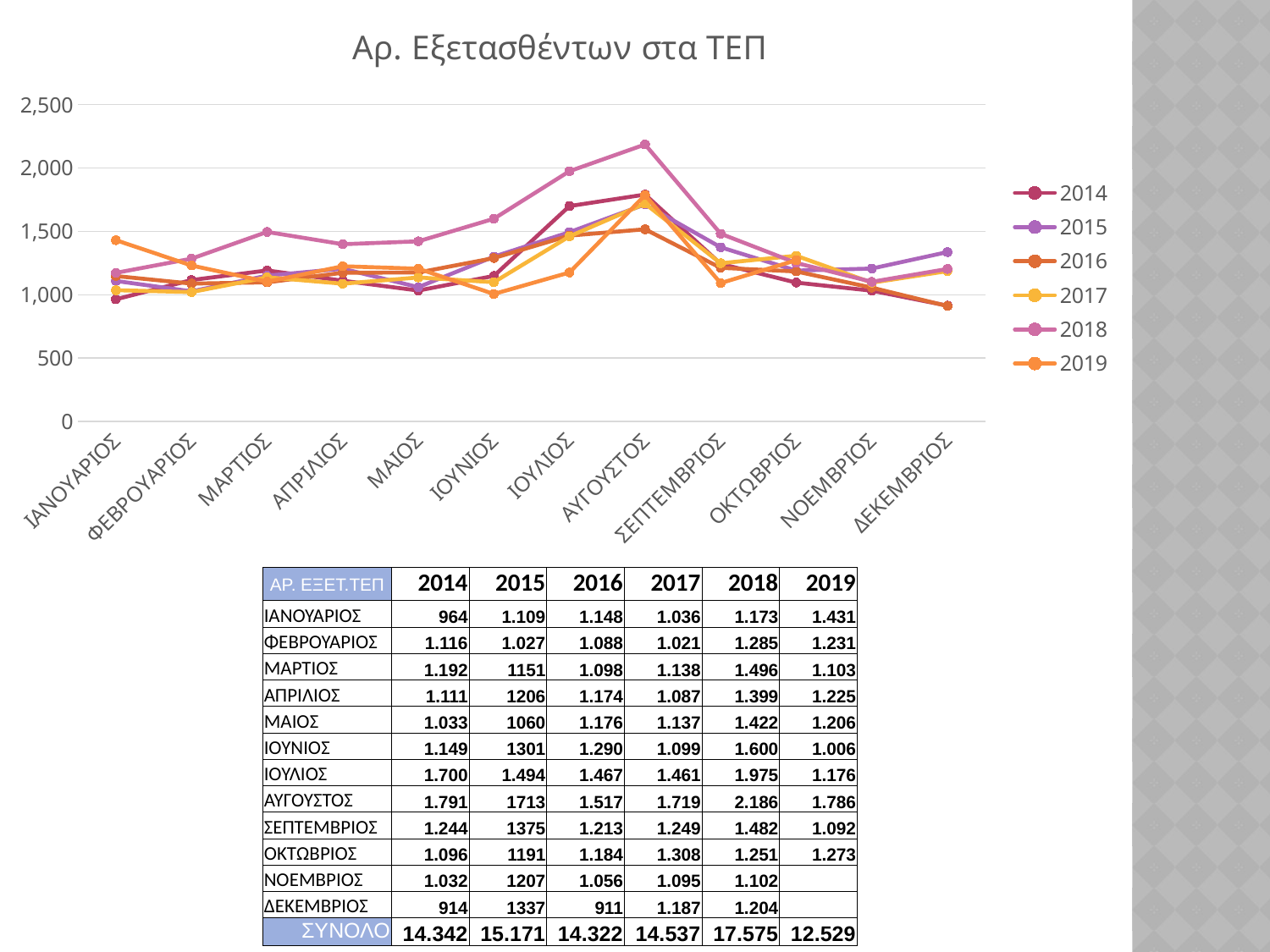
What is the value for 2019 in ΙΑΝΟΥΑΡΙΟΣ? 1.431 What is the ΣΥΝΟΛΟ (total) for 2018? 17.575 What is the title of the chart? Αρ. Εξετασθέντων στα ΤΕΠ What is the value for 2018 in ΑΥΓΟΥΣΤΟΣ? 2.186 How many month categories are shown on the x axis? 12 What kind of chart is shown on the slide? line chart In which month is the 2014 series at its lowest? ΔΕΚΕΜΒΡΙΟΣ How many series does the legend list? 6 Is the value for 2018 in ΑΥΓΟΥΣΤΟΣ greater or less than 2,000? greater Which year has the highest value in ΑΥΓΟΥΣΤΟΣ? 2018 What is the difference between the 2018 and 2014 values in ΑΥΓΟΥΣΤΟΣ? 395 Which is larger in ΙΟΥΛΙΟΣ, the value for 2018 or the value for 2014? 2018